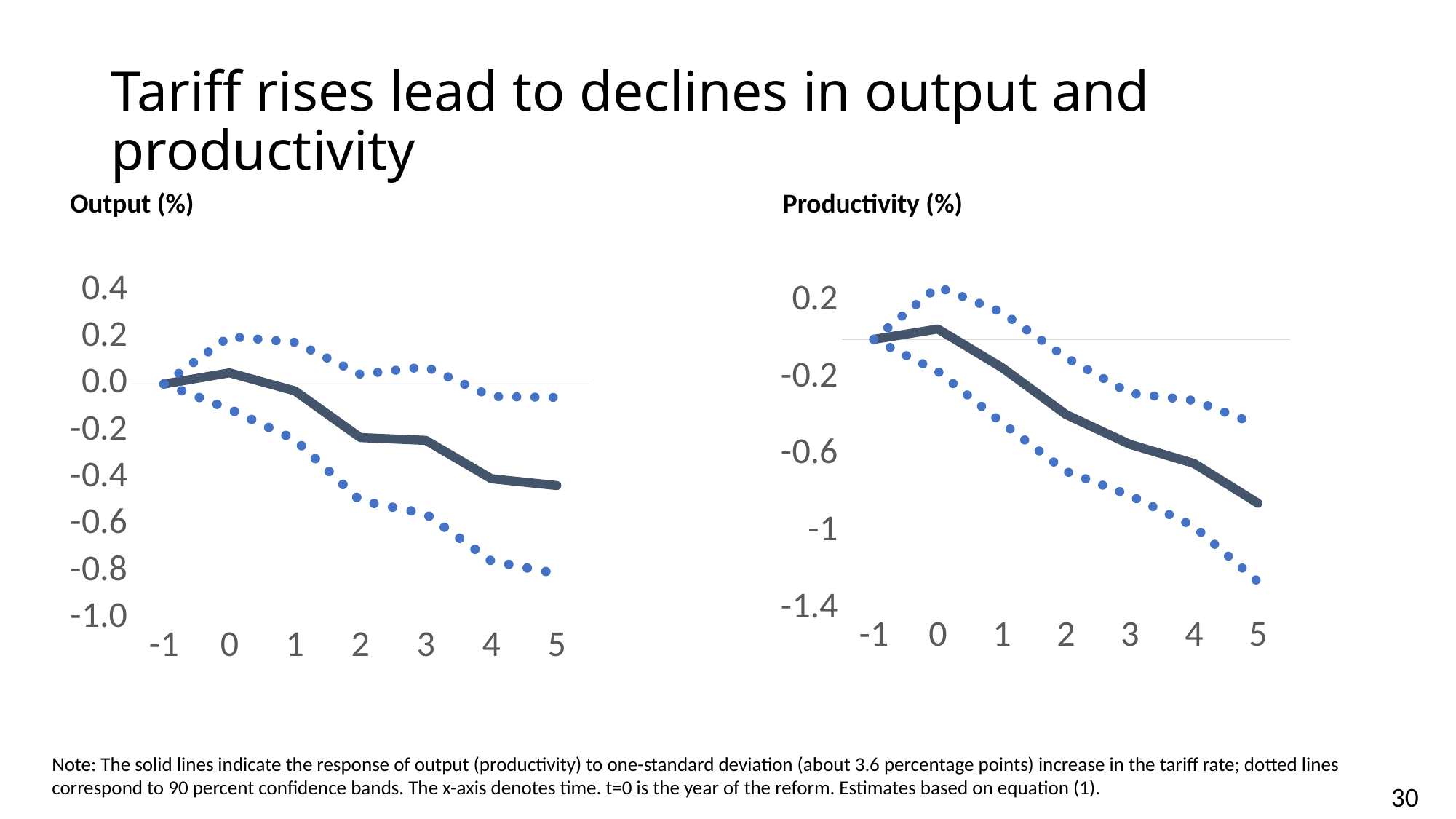
In the Output (%) chart, does the solid line rise or fall from year 0 to year 5? fall What is the lowest y-axis tick label on the Productivity (%) chart? -1.4 In the Output (%) chart, is the solid line's value at year 2 greater or less than 0.0? less In the Productivity (%) chart, at which year does the solid line reach its highest value? 0 In the Productivity (%) chart, is the solid line's value at year 2 greater or less than -0.2? less How many time points are shown on the x axis of the Productivity (%) chart? 7 What kind of chart is the Output (%) chart? line chart In the Productivity (%) chart, is the solid line's value at year 5 greater or less than -0.6? less In the Productivity (%) chart, at which year does the solid line reach its lowest value? 5 In the Productivity (%) chart, does the solid line rise or fall from year 0 to year 5? fall In the Output (%) chart, which is larger: the solid line's value at year 0 or at year 5? year 0